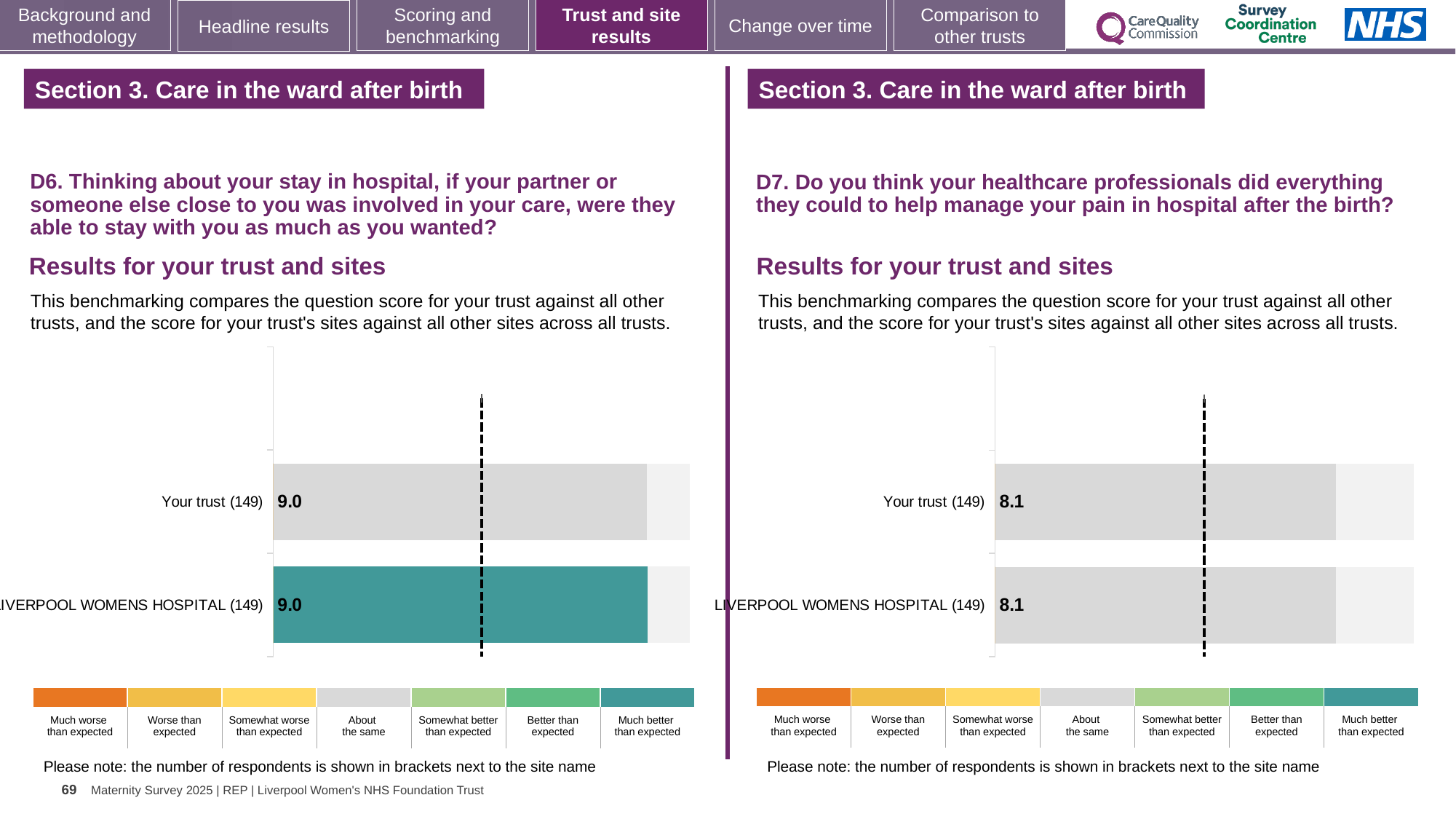
On the D6 chart (left), which benchmark category does the colour of the LIVERPOOL WOMENS HOSPITAL bar correspond to in the legend? Much better than expected How many respondents are shown in brackets next to LIVERPOOL WOMENS HOSPITAL on the D6 chart (left)? 149 How many bars are plotted on the D7 chart (right)? 2 On the D7 chart (right), what is the score for Your trust? 8.1 On the D7 chart (right), which benchmark category does the colour of the Your trust bar correspond to in the legend? About the same What kind of chart is used on the D6 chart (left)? Bar chart How many bars are plotted on the D6 chart (left)? 2 On the D7 chart (right), what is the difference between the score for Your trust and the score for LIVERPOOL WOMENS HOSPITAL? 0.0 On the D7 chart (right), what is the score for LIVERPOOL WOMENS HOSPITAL? 8.1 On the D6 chart (left), what is the score for LIVERPOOL WOMENS HOSPITAL? 9.0 On the D6 chart (left), what is the difference between the score for Your trust and the score for LIVERPOOL WOMENS HOSPITAL? 0.0 On the D6 chart (left), what is the score for Your trust? 9.0